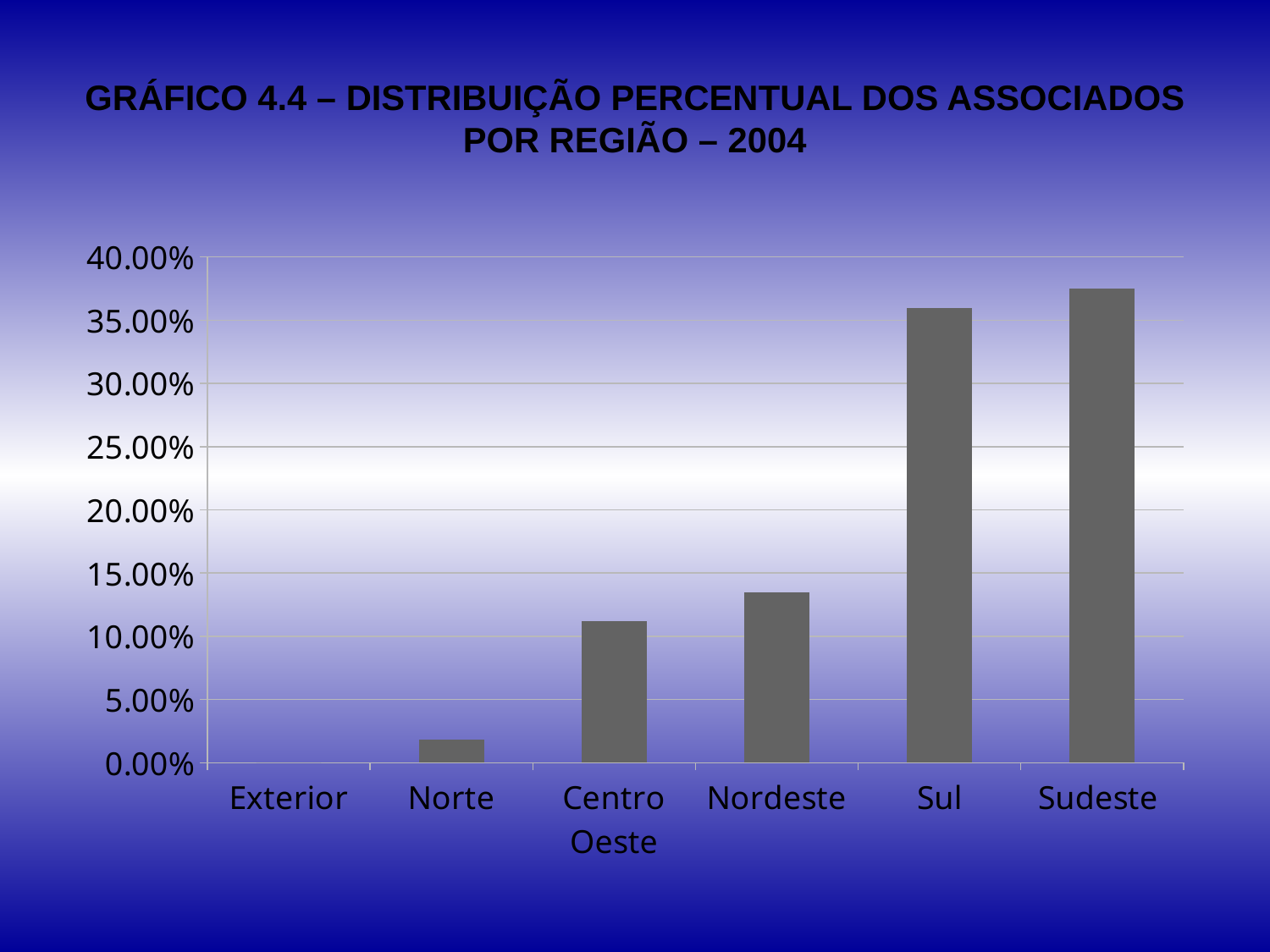
Is the value for Norte greater or less than 5.00%? less Is the value for Centro Oeste greater or less than 10.00%? greater Is the value for Sudeste greater or less than 40.00%? less What year does the chart title refer to? 2004 Do the values generally rise or fall moving from left to right along the x axis? rise Which has a larger value, Nordeste or Centro Oeste? Nordeste How many regions (categories) are shown on the x axis? 6 What kind of chart is shown on the slide? bar chart Which region has the lowest percentage of associados? Exterior Which region has the highest percentage of associados? Sudeste